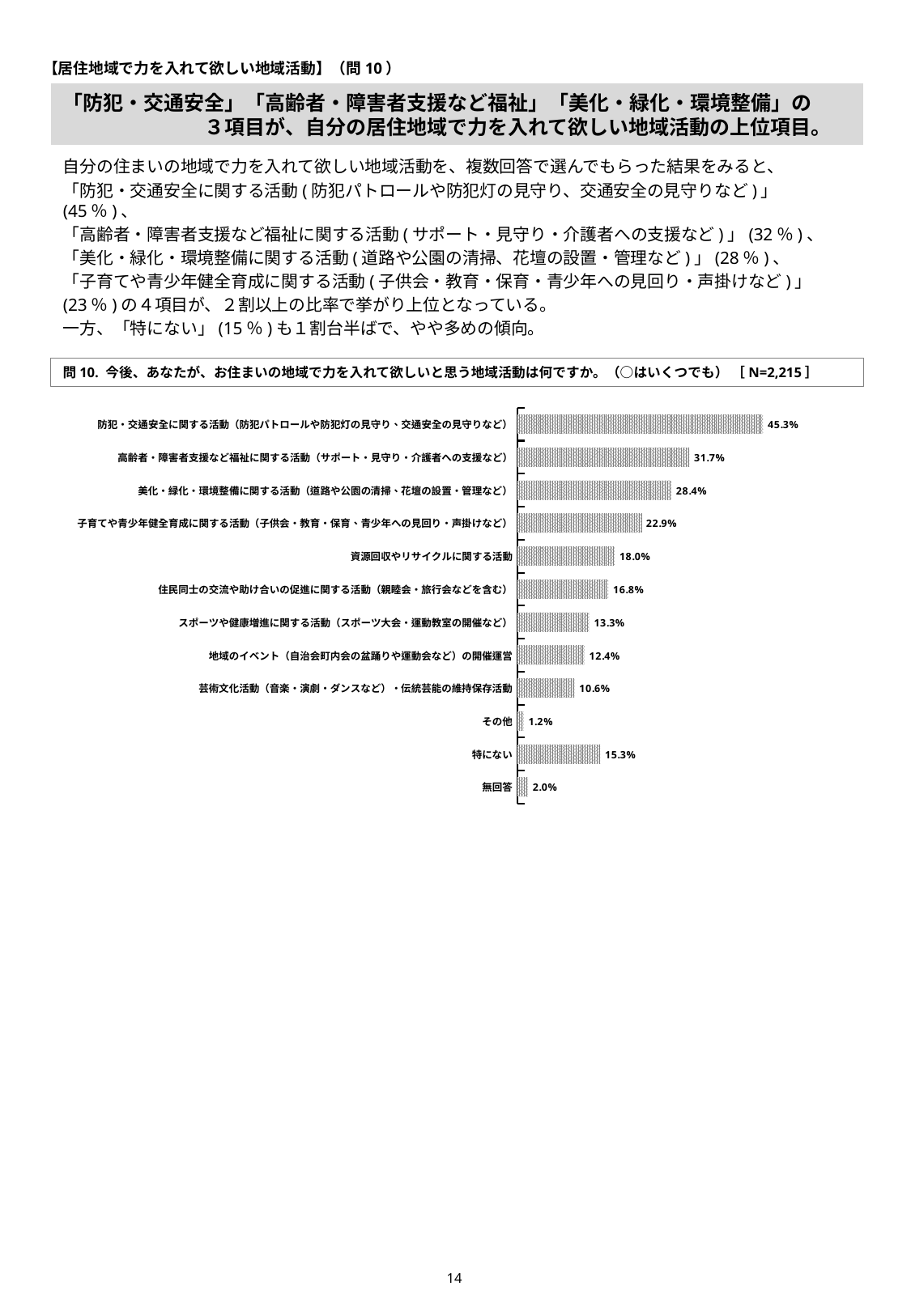
Which category has the highest value? 防犯・交通安全に関する活動 What is the value for 資源回収やリサイクルに関する活動? 18.0% Which category has the lowest value? その他 What is the sample size (N) shown in the question heading above the chart? 2,215 Which is larger: スポーツや健康増進に関する活動 or 地域のイベントの開催運営? スポーツや健康増進に関する活動 How many categories are shown in the chart? 12 What is the difference between 子育てや青少年健全育成に関する活動 and 資源回収やリサイクルに関する活動? 4.9% What is the value for 無回答? 2.0% What kind of chart is this? Bar chart What is the difference between 高齢者・障害者支援など福祉に関する活動 and 美化・緑化・環境整備に関する活動? 3.3% What is the value for 防犯・交通安全に関する活動? 45.3% What is the value for 特にない? 15.3%